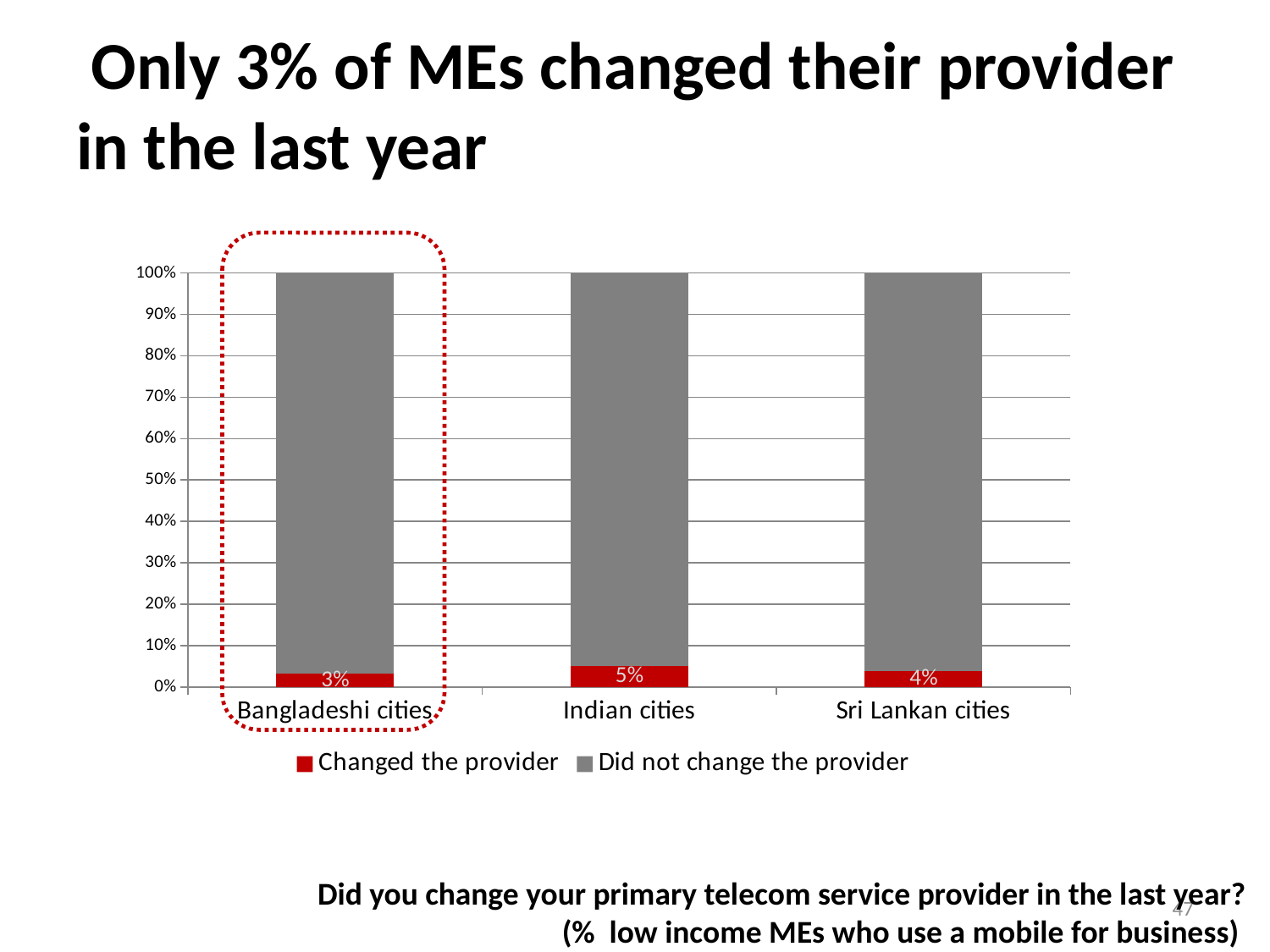
What percentage of MEs in Indian cities changed the provider? 5% What percentage of MEs in Sri Lankan cities changed the provider? 4% Which is larger: the 'Changed the provider' value for Sri Lankan cities or for Bangladeshi cities? Sri Lankan cities What percentage of MEs in Bangladeshi cities changed the provider? 3% How many categories are shown on the x axis? 3 How many series does the legend list? 2 Which category has the lowest share of MEs who changed the provider? Bangladeshi cities Which colour represents 'Changed the provider' in the legend? Red What is the difference between the 'Changed the provider' values for Indian cities and Bangladeshi cities? 2% What kind of chart is shown on the slide? Stacked bar chart Which category has the highest share of MEs who changed the provider? Indian cities Is the 'Did not change the provider' value for Indian cities greater or less than 90%? greater